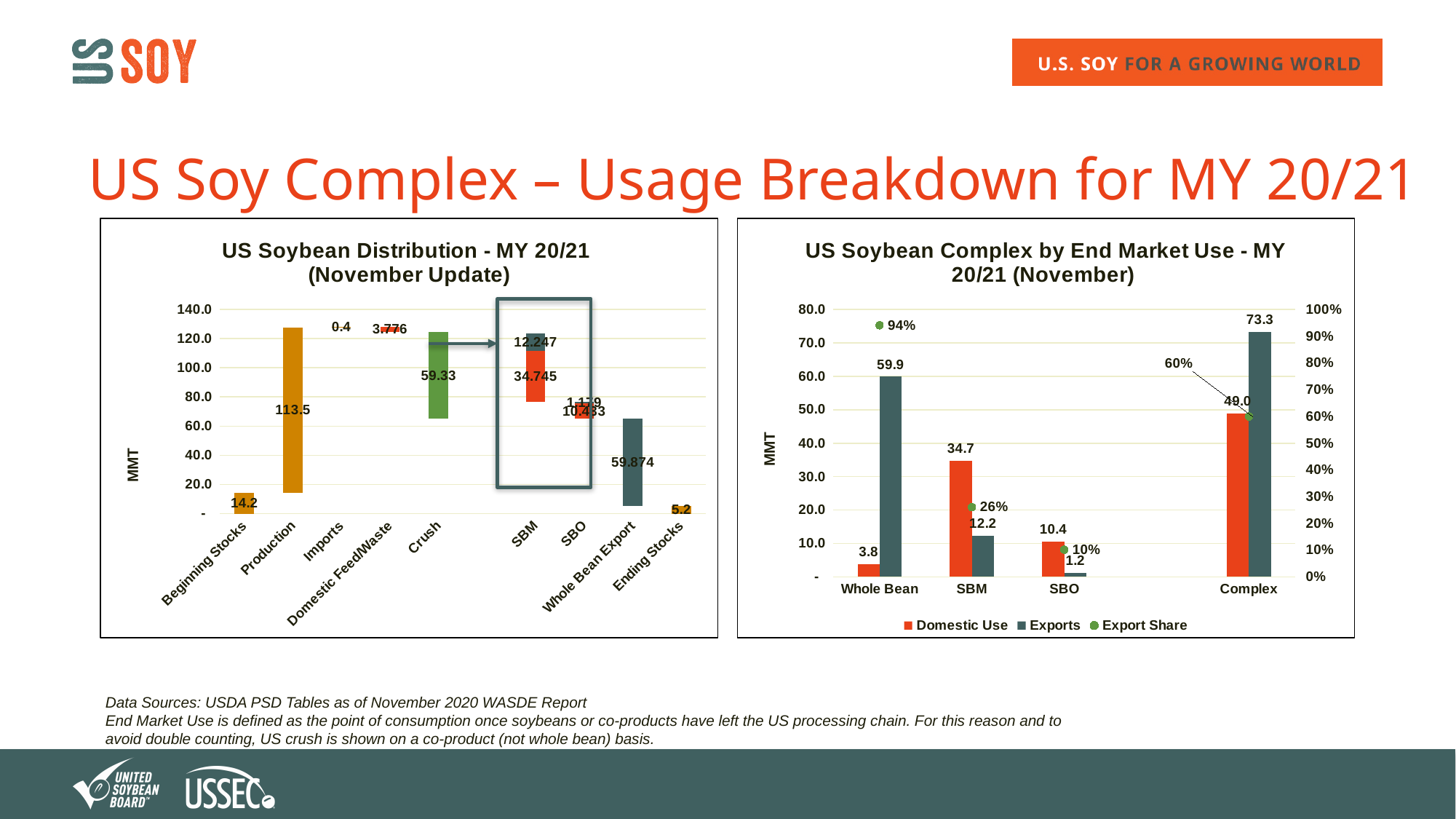
In the chart titled "US Soybean Complex by End Market Use - MY 20/21 (November)", which category has the highest Exports value? Complex In the chart titled "US Soybean Complex by End Market Use - MY 20/21 (November)", which category has the lowest Exports value? SBO In the chart titled "US Soybean Complex by End Market Use - MY 20/21 (November)", how many series does the legend list? 3 In the chart titled "US Soybean Complex by End Market Use - MY 20/21 (November)", what is the Domestic Use value for SBM? 34.7 In the chart titled "US Soybean Complex by End Market Use - MY 20/21 (November)", what is the Exports value for Whole Bean? 59.9 In the chart titled "US Soybean Distribution - MY 20/21 (November Update)", what is the value for Production? 113.5 In the chart titled "US Soybean Complex by End Market Use - MY 20/21 (November)", what is the difference between Exports and Domestic Use for Complex? 24.3 In the chart titled "US Soybean Complex by End Market Use - MY 20/21 (November)", what is the Export Share for Complex? 60% In the chart titled "US Soybean Complex by End Market Use - MY 20/21 (November)", how many categories are shown on the x axis? 4 In the chart titled "US Soybean Complex by End Market Use - MY 20/21 (November)", for SBM, which is larger: Domestic Use or Exports? Domestic Use What kind of chart is the one titled "US Soybean Distribution - MY 20/21 (November Update)"? Bar chart In the chart titled "US Soybean Distribution - MY 20/21 (November Update)", what is the value for Whole Bean Export? 59.874